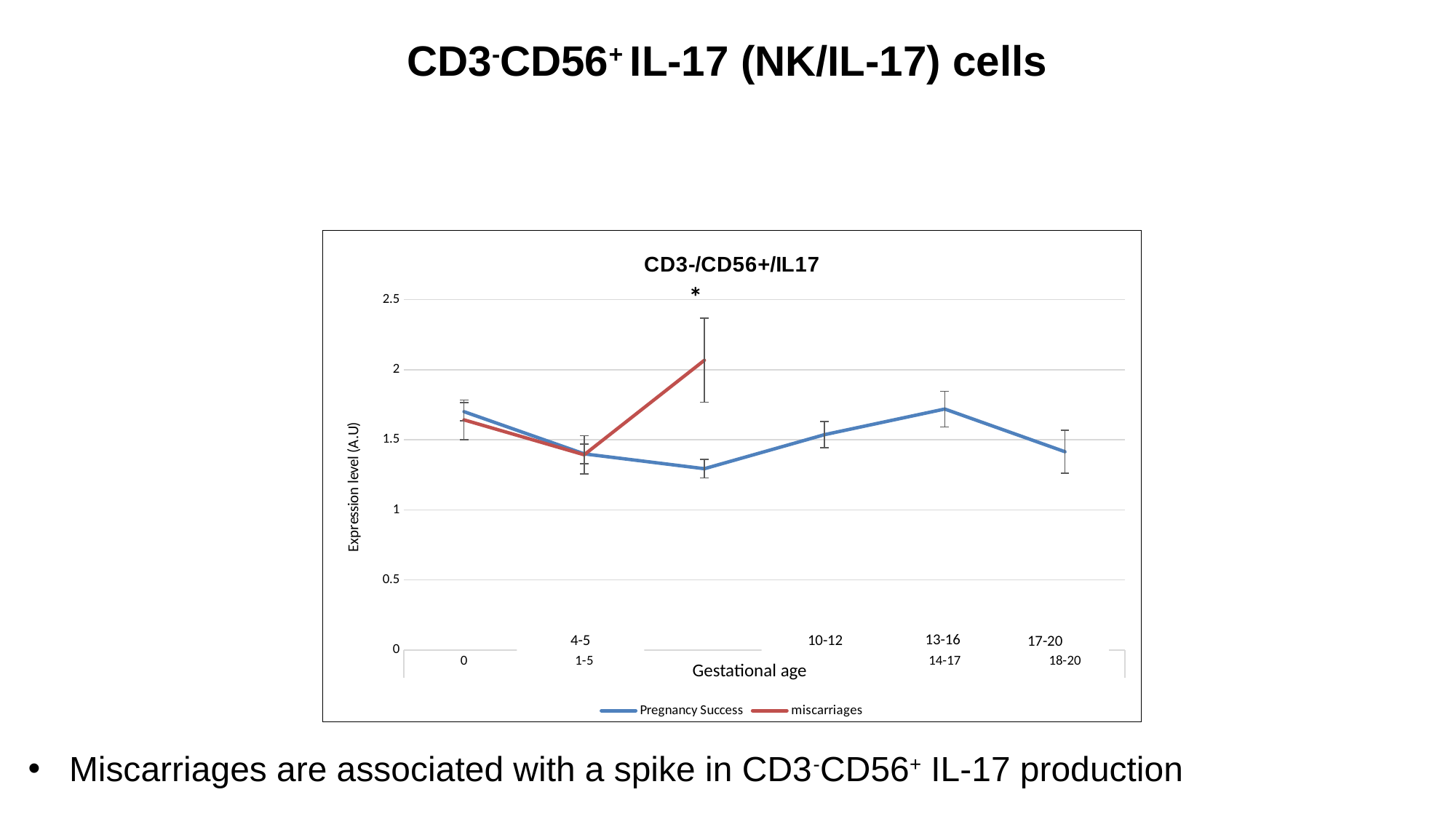
Does the miscarriages line rise or fall between gestational age 4-5 and its last point? rise What kind of chart is shown on the slide? line chart Is the Pregnancy Success value at gestational age 13-16 greater or less than 1.5? greater Is the Pregnancy Success value at gestational age 0 greater or less than 1.5? greater How many data points does the Pregnancy Success line have? 6 What is the title of the chart's vertical axis? Expression level (A.U) How many data points does the miscarriages line have? 3 Is the Pregnancy Success value at gestational age 17-20 greater or less than 1.5? less At the third gestational age point, which series has the higher value, Pregnancy Success or miscarriages? miscarriages How many series does the chart legend list? 2 Which series is drawn in red in the chart? miscarriages